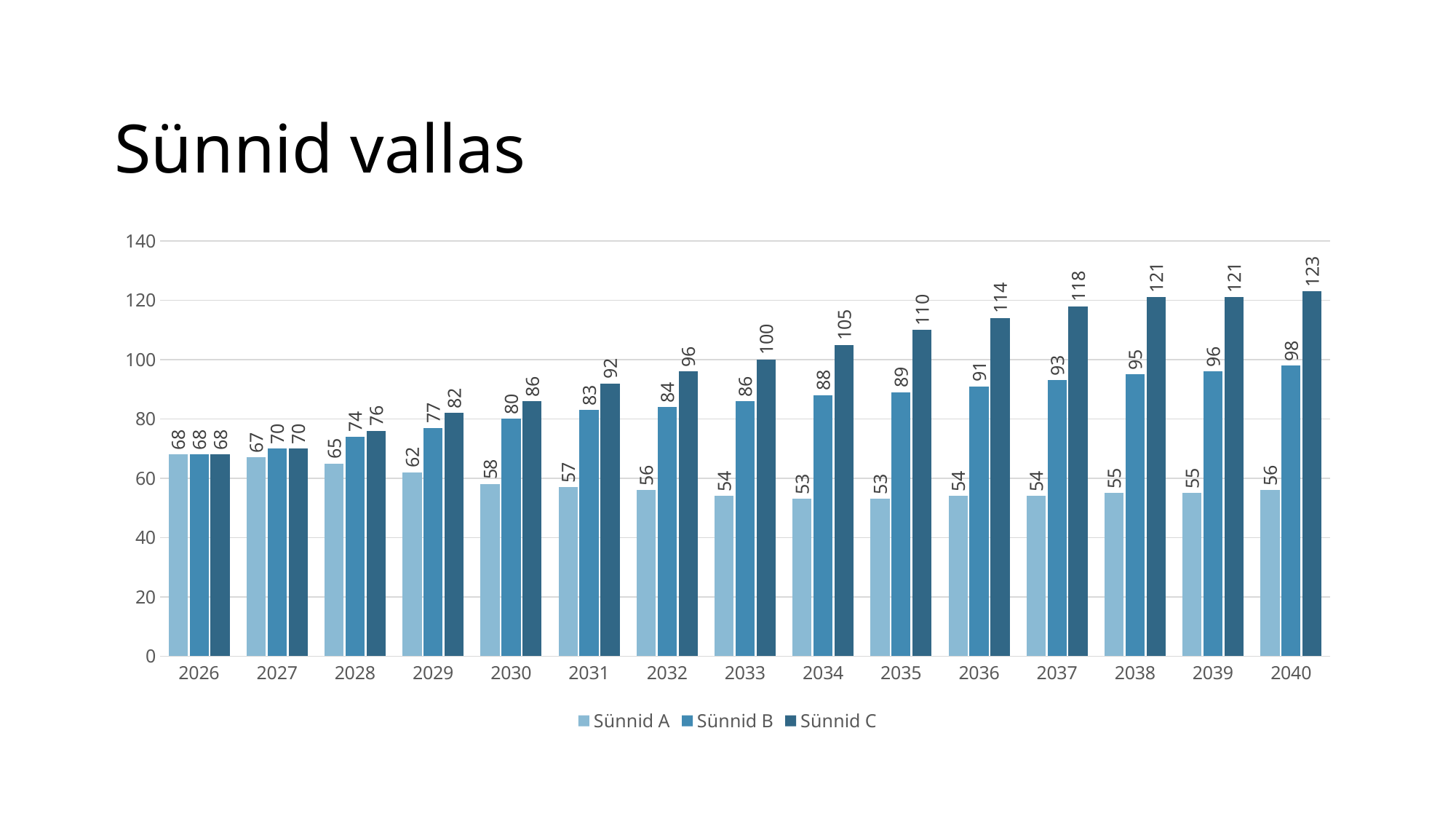
In which year is Sünnid A lowest? 2034 and 2035 How many series does the legend list? 3 What is the value of Sünnid C in 2040? 123 What is the value of Sünnid A in 2034? 53 What is the value of Sünnid B in 2031? 83 In which year is Sünnid C highest? 2040 What kind of chart is shown on the slide? bar chart Which is larger in 2033: Sünnid B or Sünnid C? Sünnid C Is the value for Sünnid C in 2038 greater or less than 100? greater Does Sünnid C rise or fall from 2026 to 2040? rise How many years are shown on the x axis? 15 What is the difference between Sünnid C and Sünnid A in 2040? 67